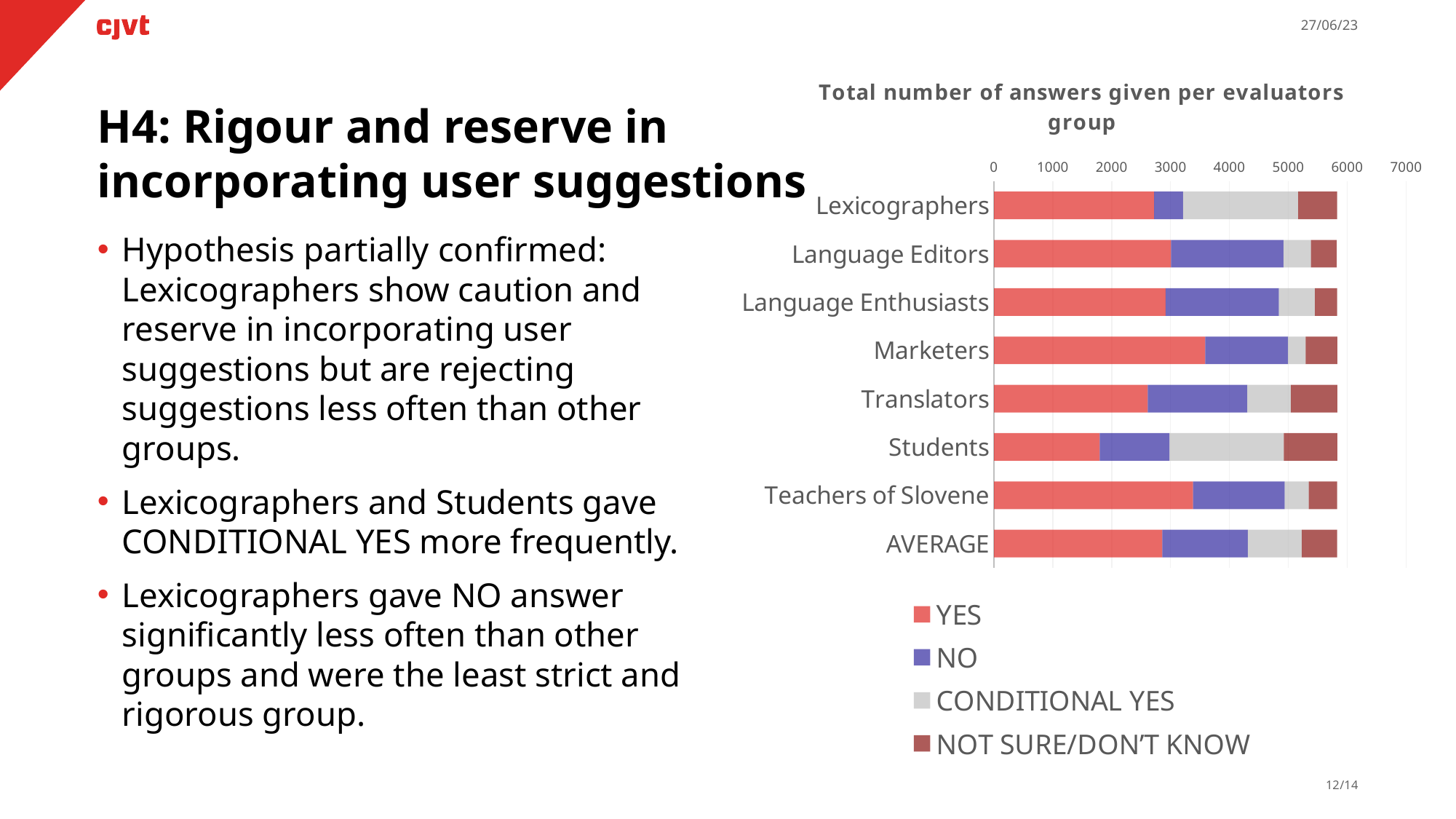
Which evaluator group has the lowest YES value? Students Which series is shown in dark red in the chart legend? NOT SURE/DON'T KNOW How many evaluator groups (categories) are shown on the chart? 8 Which is larger, the CONDITIONAL YES segment for Lexicographers or for Marketers? Lexicographers Is the YES value for Lexicographers greater or less than 3000? less What is the title of the chart? Total number of answers given per evaluators group How many series does the chart legend list? 4 Is the YES value for Marketers greater or less than 3000? greater Is the YES value for Students greater or less than 2000? less Which evaluator group has the smallest NO segment? Lexicographers What kind of chart is shown on the slide? Stacked bar chart Which is larger, the NO segment for Lexicographers or the NO segment for Language Editors? Language Editors